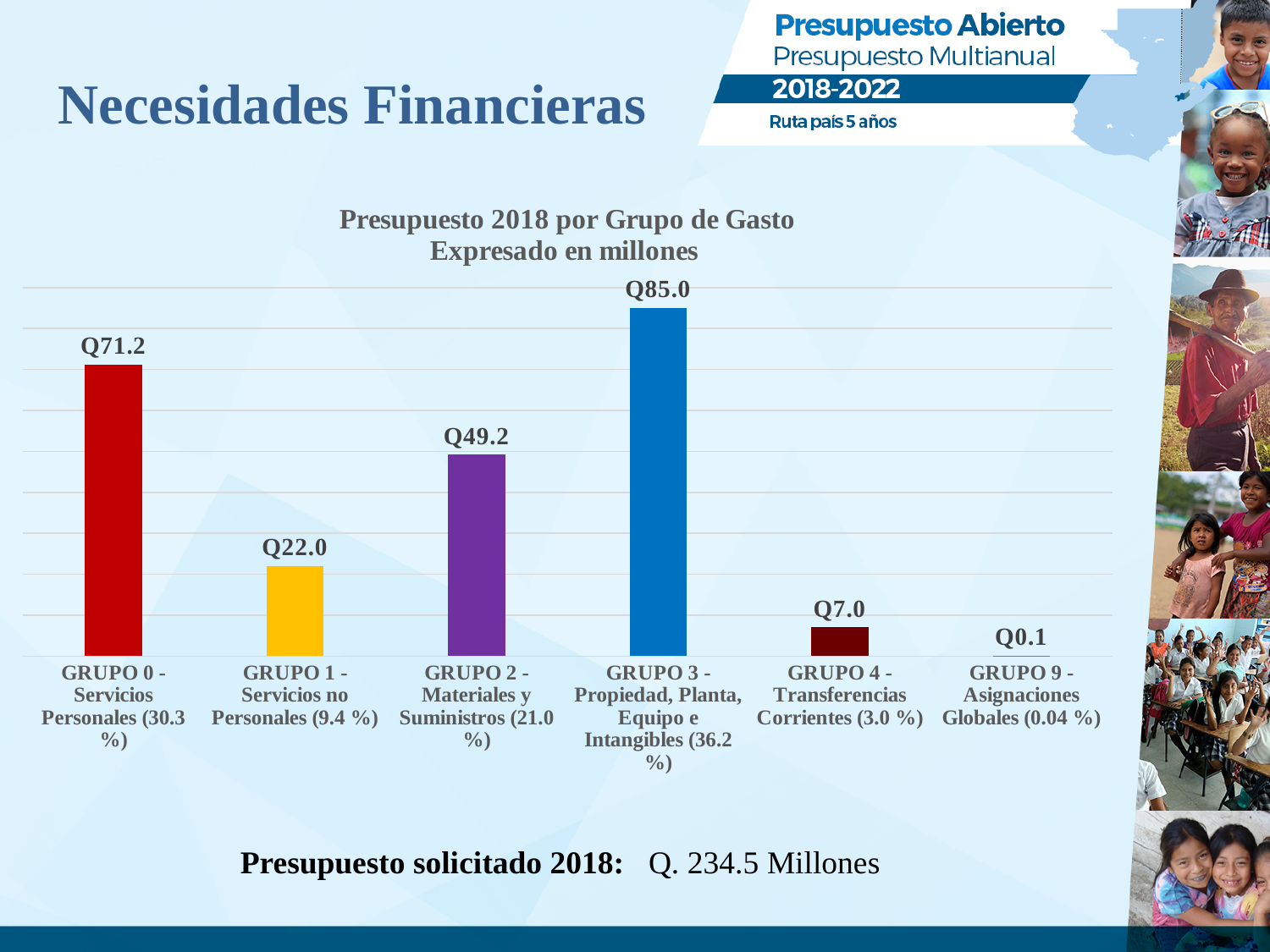
What is the value for GRUPO 4 - Transferencias Corrientes? Q7.0 What is the value for GRUPO 0 - Servicios Personales? Q71.2 What is the difference between the values for GRUPO 2 and GRUPO 1? Q27.2 How many groups are shown in the chart? 6 Which group has the lowest value? GRUPO 9 - Asignaciones Globales What is the title of the chart? Presupuesto 2018 por Grupo de Gasto Expresado en millones What is the value for GRUPO 3 - Propiedad, Planta, Equipo e Intangibles? Q85.0 What is the difference between the values for GRUPO 3 and GRUPO 0? Q13.8 Which is larger, the value for GRUPO 1 - Servicios no Personales or GRUPO 2 - Materiales y Suministros? GRUPO 2 - Materiales y Suministros What kind of chart is shown on the slide? Bar chart Which group has the highest value? GRUPO 3 - Propiedad, Planta, Equipo e Intangibles What percentage share is shown in the label for GRUPO 2 - Materiales y Suministros? 21.0 %